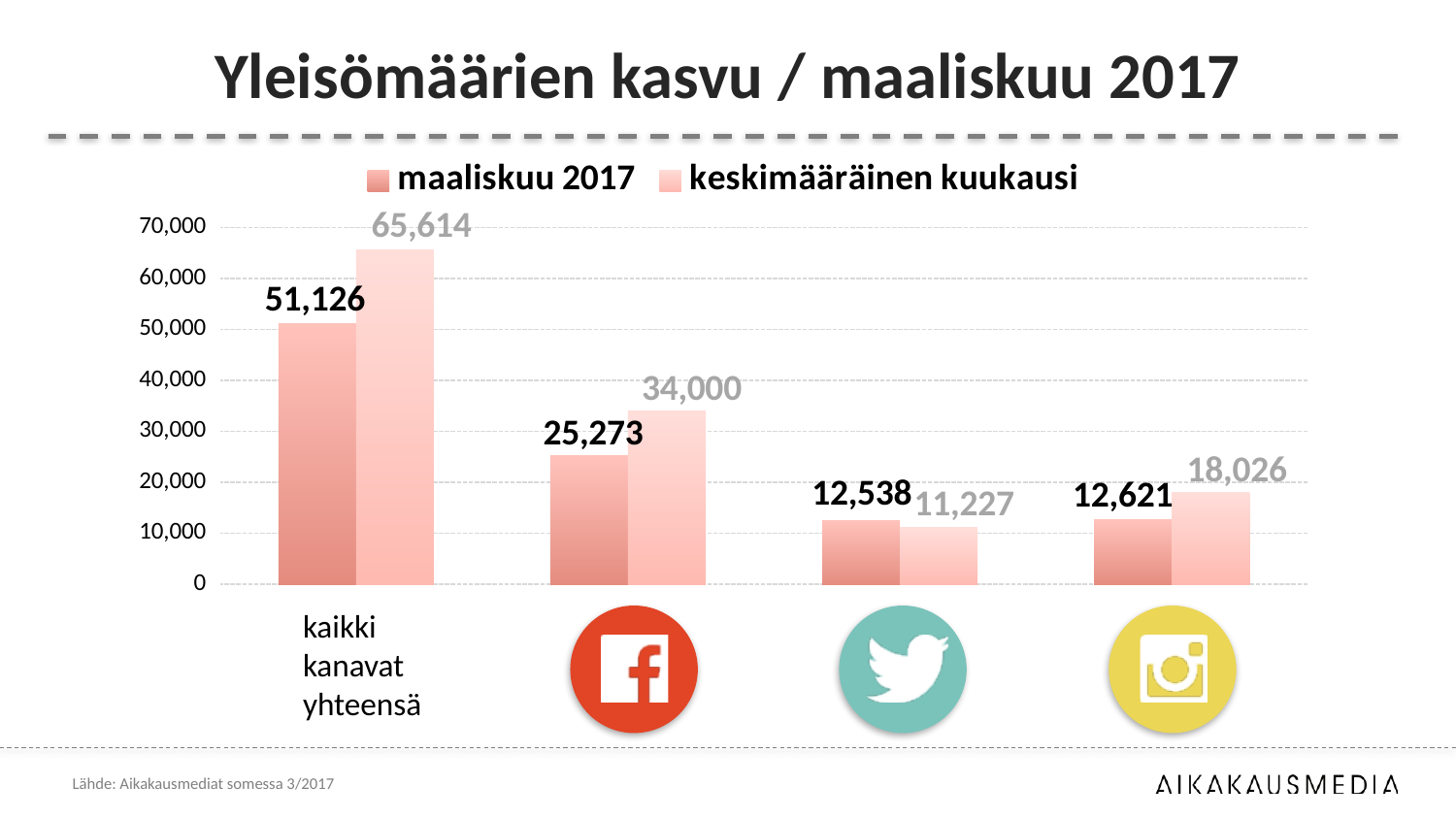
What is the value for 'kaikki kanavat yhteensä' in the 'maaliskuu 2017' series? 51,126 What is the 'keskimääräinen kuukausi' value for the Instagram category (rightmost)? 18,026 Which category has the lowest 'keskimääräinen kuukausi' value? Twitter (third from left) What is the value for 'kaikki kanavat yhteensä' in the 'keskimääräinen kuukausi' series? 65,614 What is the difference between the 'keskimääräinen kuukausi' and 'maaliskuu 2017' values for the Facebook category? 8,727 For the Twitter category (third from left), which series has the larger value: 'maaliskuu 2017' or 'keskimääräinen kuukausi'? maaliskuu 2017 What is the 'maaliskuu 2017' value for the Facebook category (second from left)? 25,273 What is the 'keskimääräinen kuukausi' value for the Twitter category (third from left)? 11,227 What type of chart is shown on the slide? bar chart What is the difference between the 'keskimääräinen kuukausi' and 'maaliskuu 2017' values for 'kaikki kanavat yhteensä'? 14,488 How many categories are shown on the x axis? 4 How many series does the legend list? 2